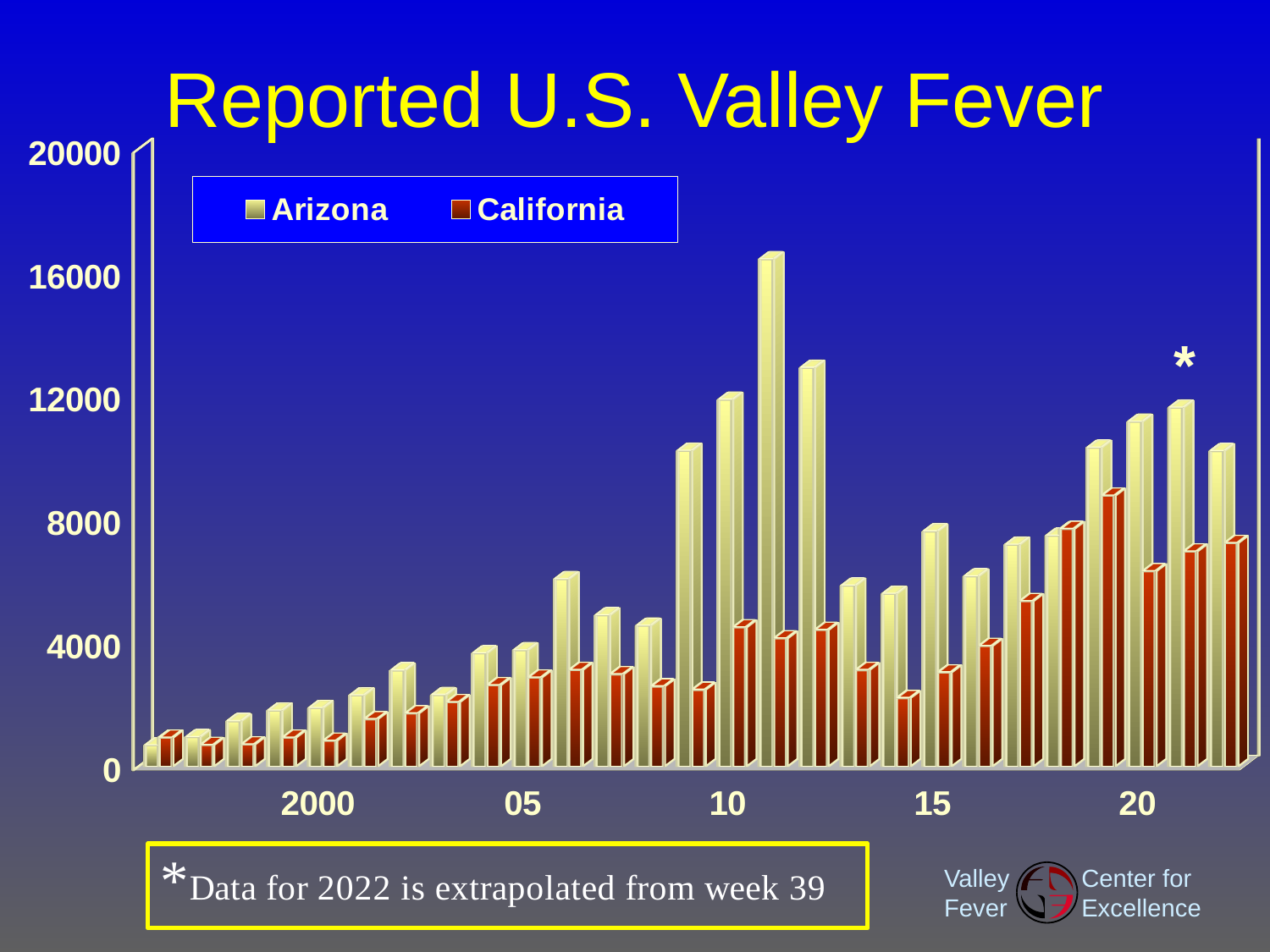
How many series does the legend list? 2 Is the Arizona value for 2000 greater or less than 4000? less Which two series are listed in the legend? Arizona and California Is the California value for 2000 greater or less than 4000? less In which year does California reach its highest value? 2019 What is the title of the chart? Reported U.S. Valley Fever In which year does Arizona reach its highest value? 2011 Do the Arizona values generally rise or fall from 2000 to 2011? rise Is the California value for 2019 greater or less than 8000? greater In 2011, which series has the larger value, Arizona or California? Arizona What kind of chart is shown on the slide? bar chart